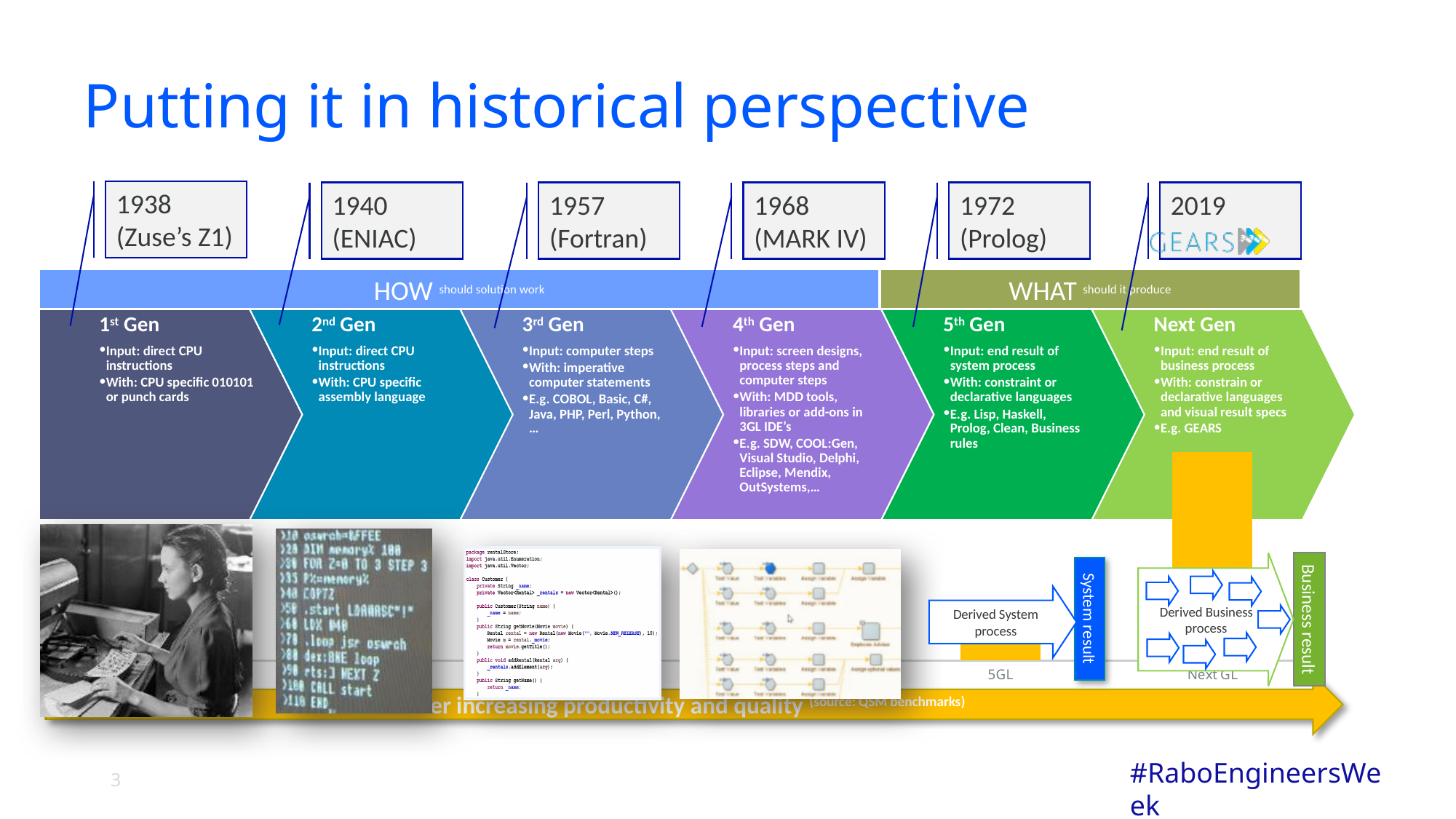
What kind of chart is shown at the bottom right of the slide with the 5GL and Next GL labels? bar chart In the bar chart at the bottom right of the slide, which bar is taller, 5GL or Next GL? Next GL In the bar chart at the bottom right of the slide, what colour are the bars? yellow